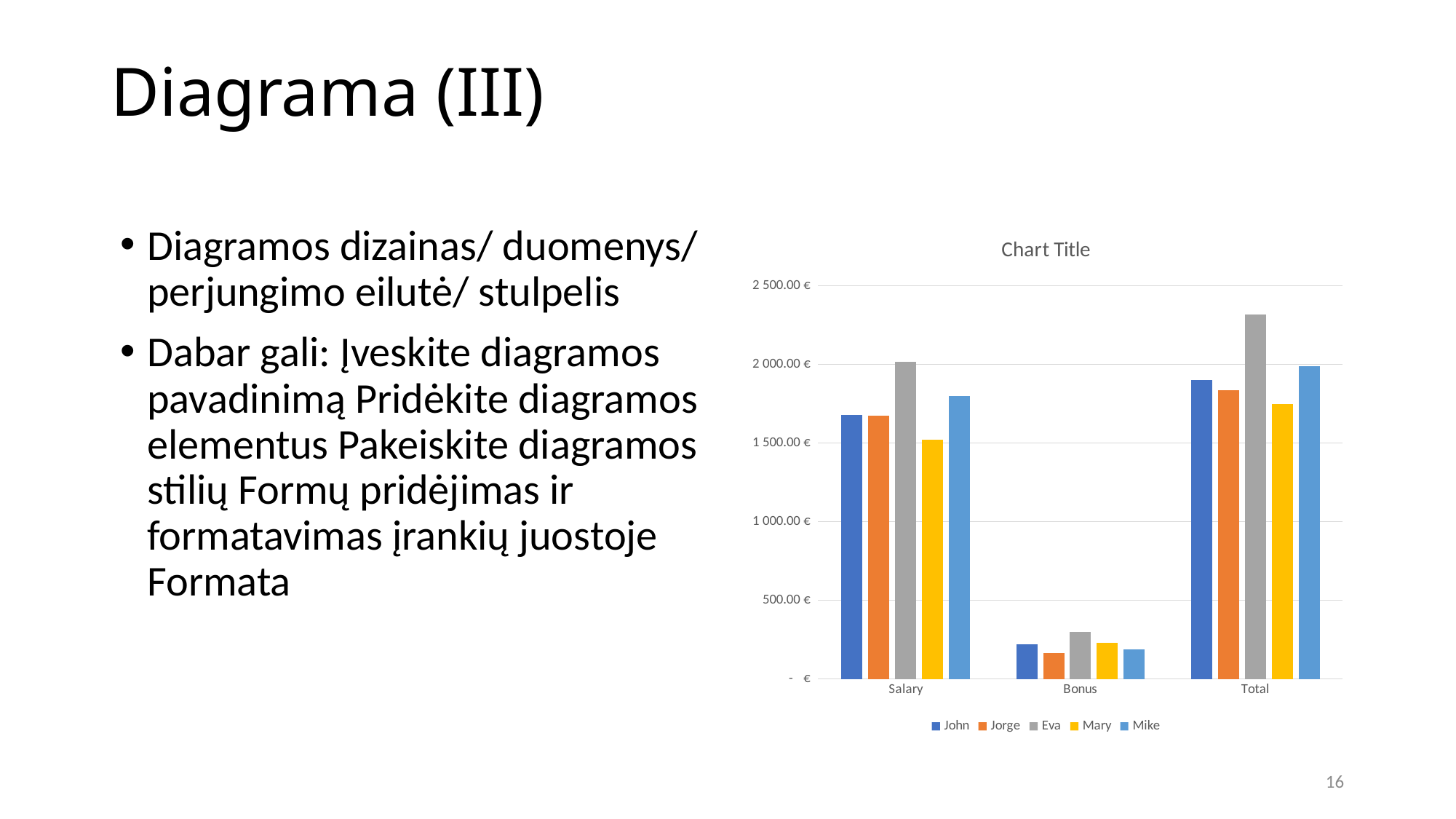
How many categories are shown on the x axis of the chart? 3 Is the value for Mary in the Salary category greater or less than 2 000.00 €? less Which series has the lowest bar in the Salary category? Mary What kind of chart is shown on the slide? bar chart How many series does the chart legend list? 5 What is the title of the chart? Chart Title In the Salary category, which is larger: the bar for Mike or the bar for Mary? Mike Which series has the highest bar in the Total category? Eva Is the value for Eva in the Total category greater or less than 2 000.00 €? greater Which series has the lowest bar in the Bonus category? Jorge Which series has the highest bar in the Salary category? Eva Is the value for Eva in the Bonus category greater or less than 500.00 €? less